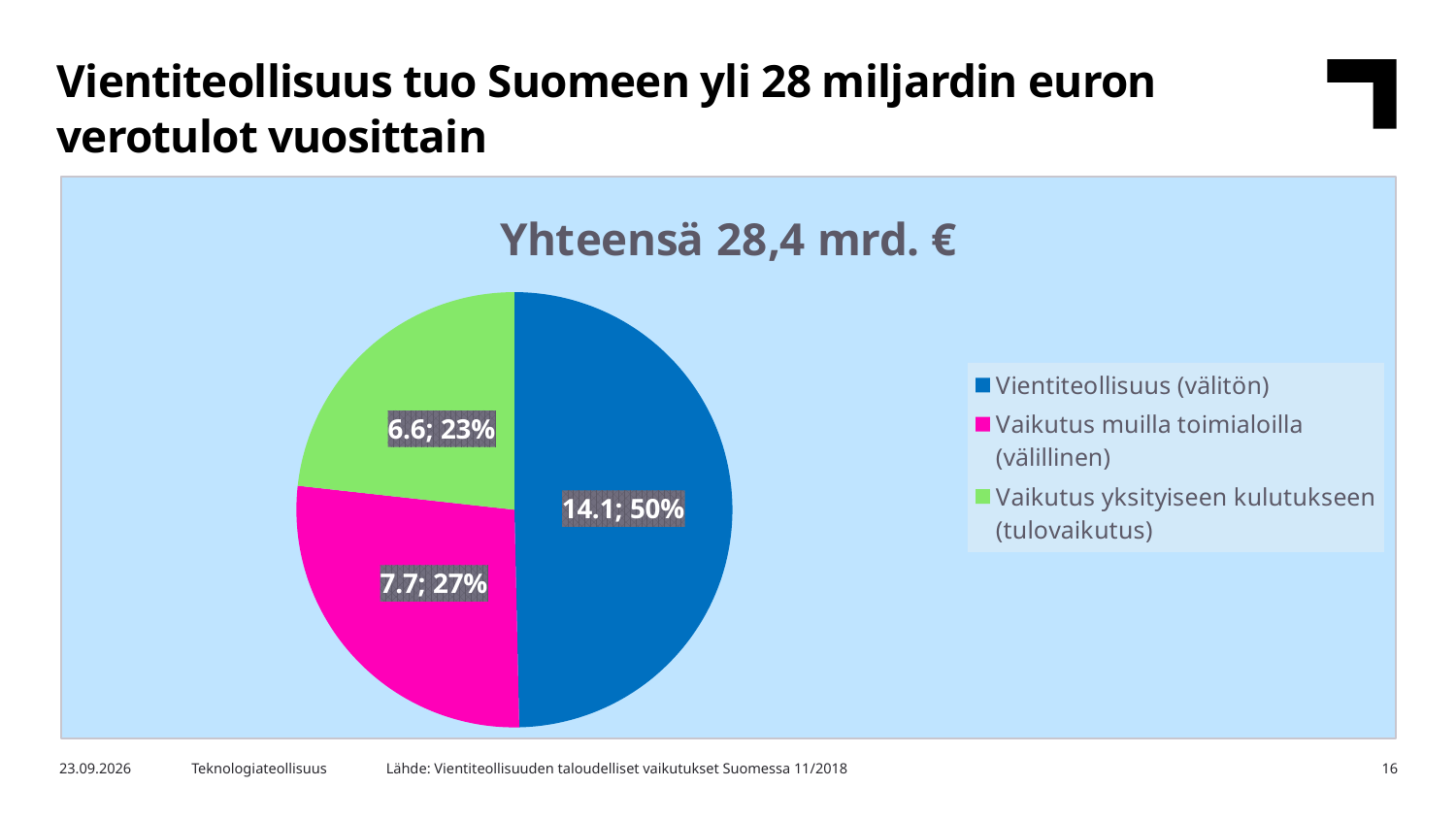
What share of the pie does Vaikutus yksityiseen kulutukseen (tulovaikutus) represent? 23% How many entries does the legend list? 3 What value is shown for Vientiteollisuus (välitön)? 14.1 What is the difference between the values for Vientiteollisuus (välitön) and Vaikutus muilla toimialoilla (välillinen)? 6.4 Which colour represents Vaikutus muilla toimialoilla (välillinen) in the pie chart? Magenta (pink) What share of the pie does Vientiteollisuus (välitön) represent? 50% What value is shown for Vaikutus muilla toimialoilla (välillinen)? 7.7 Which slice is the smallest? Vaikutus yksityiseen kulutukseen (tulovaikutus) How many slices does the pie chart have? 3 What is the title of the chart? Yhteensä 28,4 mrd. € What kind of chart is shown on the slide? Pie chart Which slice is the largest? Vientiteollisuus (välitön)